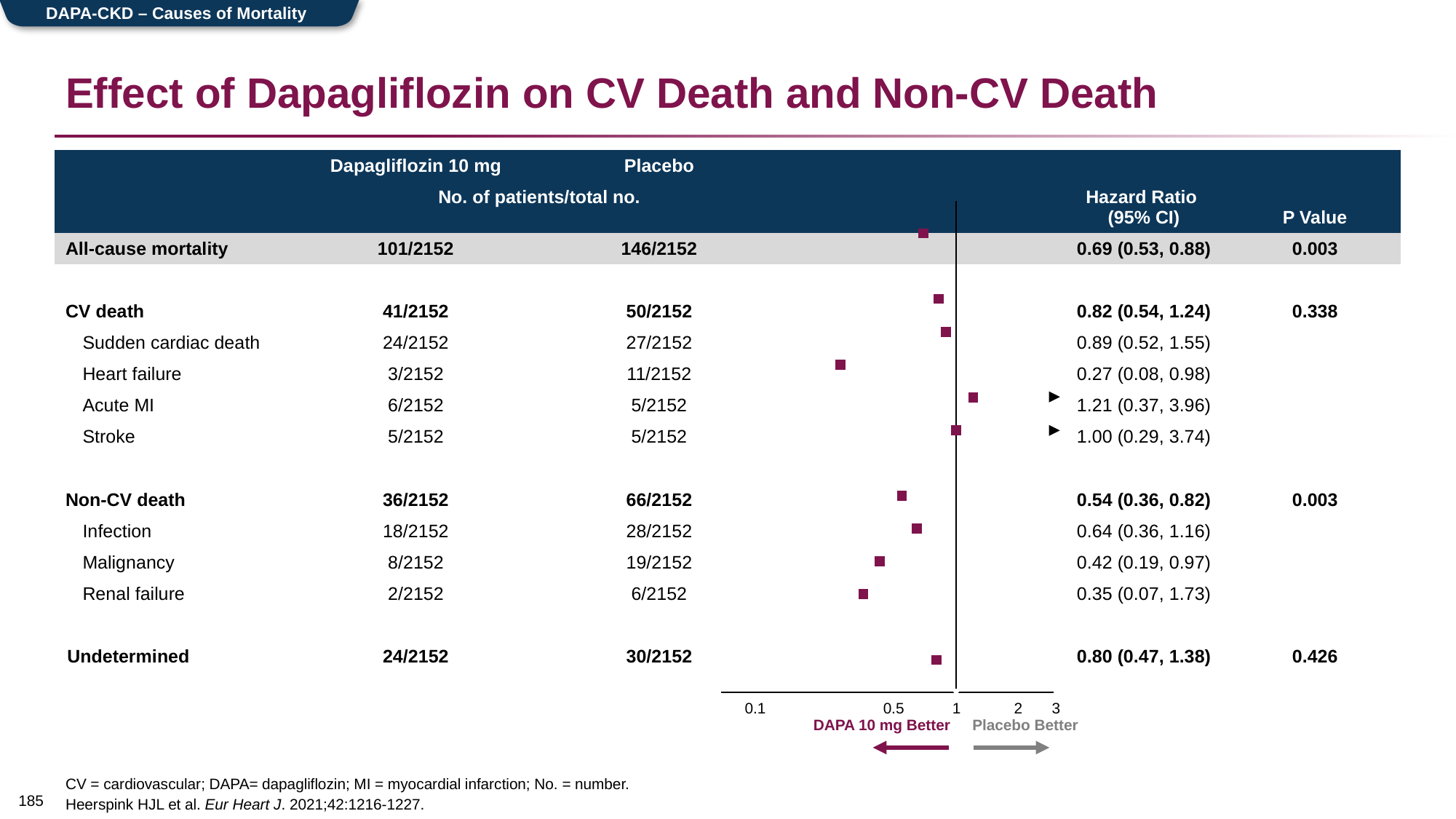
Is the hazard ratio for renal failure greater or less than 0.5? less Which has the larger hazard ratio, CV death or non-CV death? CV death How many hazard ratio points are plotted in the forest plot? 11 How many patients in the placebo group had a malignancy death? 19/2152 What is the hazard ratio (95% CI) for all-cause mortality? 0.69 (0.53, 0.88) Which cause of death has the lowest hazard ratio in the forest plot? Heart failure How many more all-cause deaths occurred in the placebo group than in the dapagliflozin 10 mg group? 45 Which cause of death has the highest hazard ratio in the forest plot? Acute MI What is the P value for non-CV death? 0.003 What is the hazard ratio (95% CI) for heart failure death? 0.27 (0.08, 0.98) What kind of chart is shown on the slide? Forest plot What does the left side of the forest plot axis (below 1) indicate? DAPA 10 mg Better